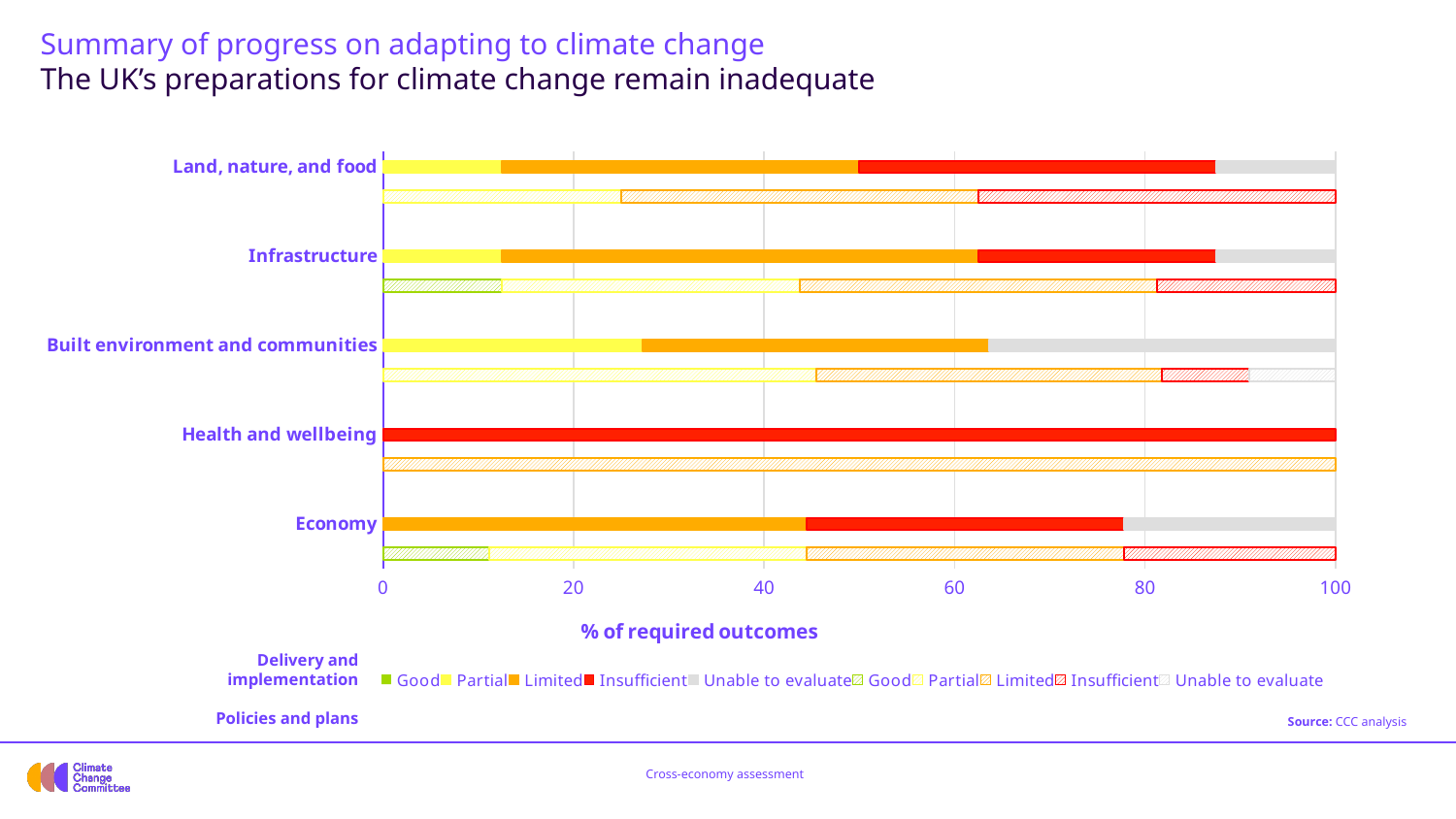
What source is cited for the chart? CCC analysis In the Delivery and implementation bars, which has the larger Partial segment: Built environment and communities or Infrastructure? Built environment and communities What is the title of the horizontal axis of the chart? % of required outcomes How many categories show a Good segment in their Policies and plans bar? 2 How many categories are shown on the vertical axis of the chart? 5 How many entries does the chart legend list? 10 What kind of chart is shown on the slide? Stacked bar chart Which category's Policies and plans bar is made up entirely of the Limited rating? Health and wellbeing Which category has the largest Insufficient share in its Delivery and implementation bar? Health and wellbeing Is the Limited segment of the Delivery and implementation bar for Economy greater or less than 60? less Is the Partial segment of the Delivery and implementation bar for Land, nature, and food greater or less than 20? less Is the Partial segment of the Delivery and implementation bar for Built environment and communities greater or less than 20? greater